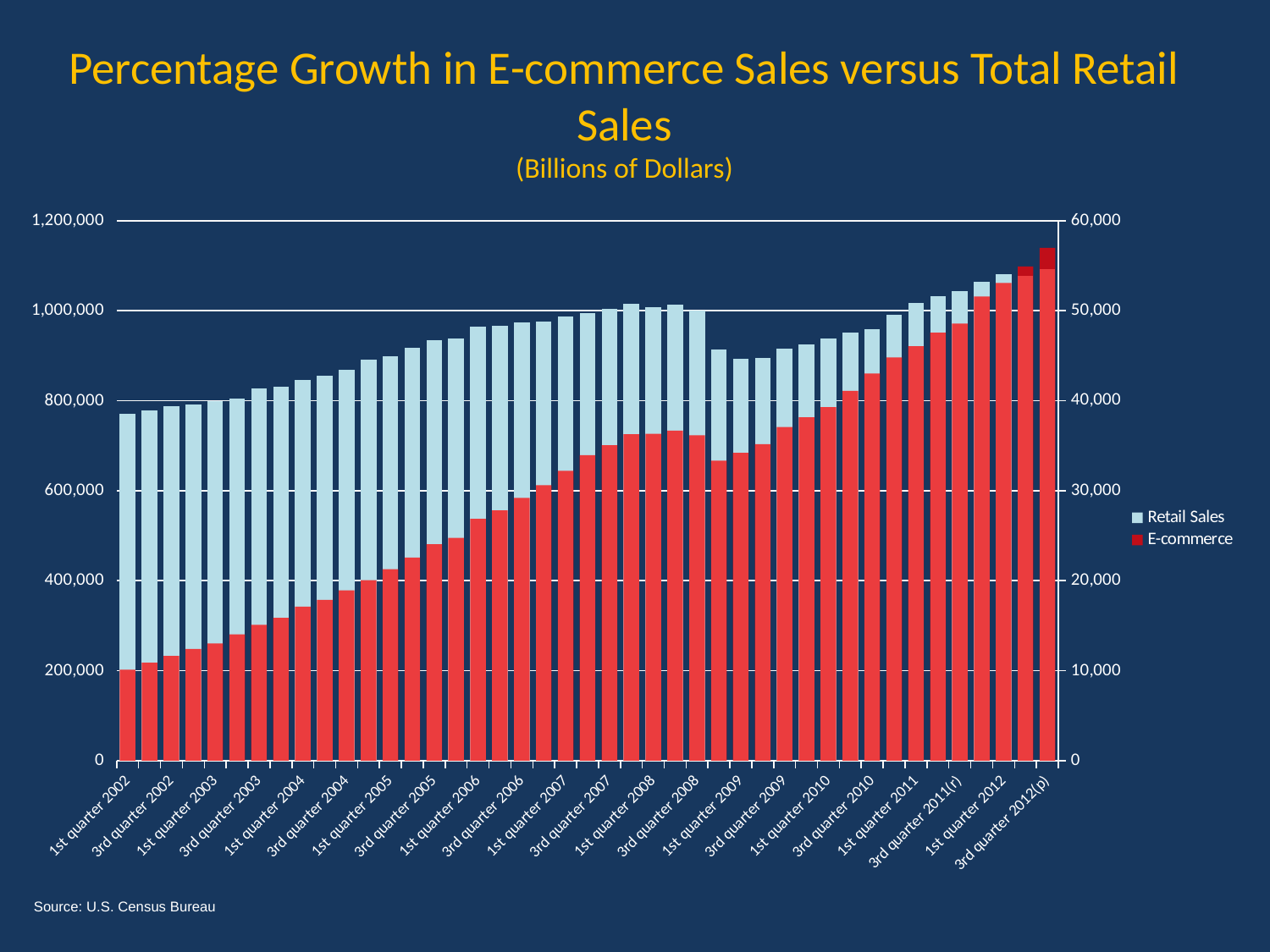
Which quarter has the lowest Retail Sales value? 1st quarter 2002 What is the title of the chart? Percentage Growth in E-commerce Sales versus Total Retail Sales Which is larger, the Retail Sales value for 1st quarter 2008 or for 1st quarter 2009? 1st quarter 2008 Which quarter has the highest E-commerce value? 3rd quarter 2012(p) What kind of chart is shown on the slide? Bar chart How many series does the legend list? 2 Do the E-commerce values generally rise or fall from 1st quarter 2002 to 3rd quarter 2012(p)? Rise Is the Retail Sales value for 1st quarter 2002 greater or less than 800,000? less Is the Retail Sales value for 1st quarter 2009 greater or less than 1,000,000? less Which quarter has the highest Retail Sales value? 3rd quarter 2012(p) Which series is shown in red? E-commerce Is the E-commerce value for 3rd quarter 2012(p) greater or less than 50,000 on the right axis? greater